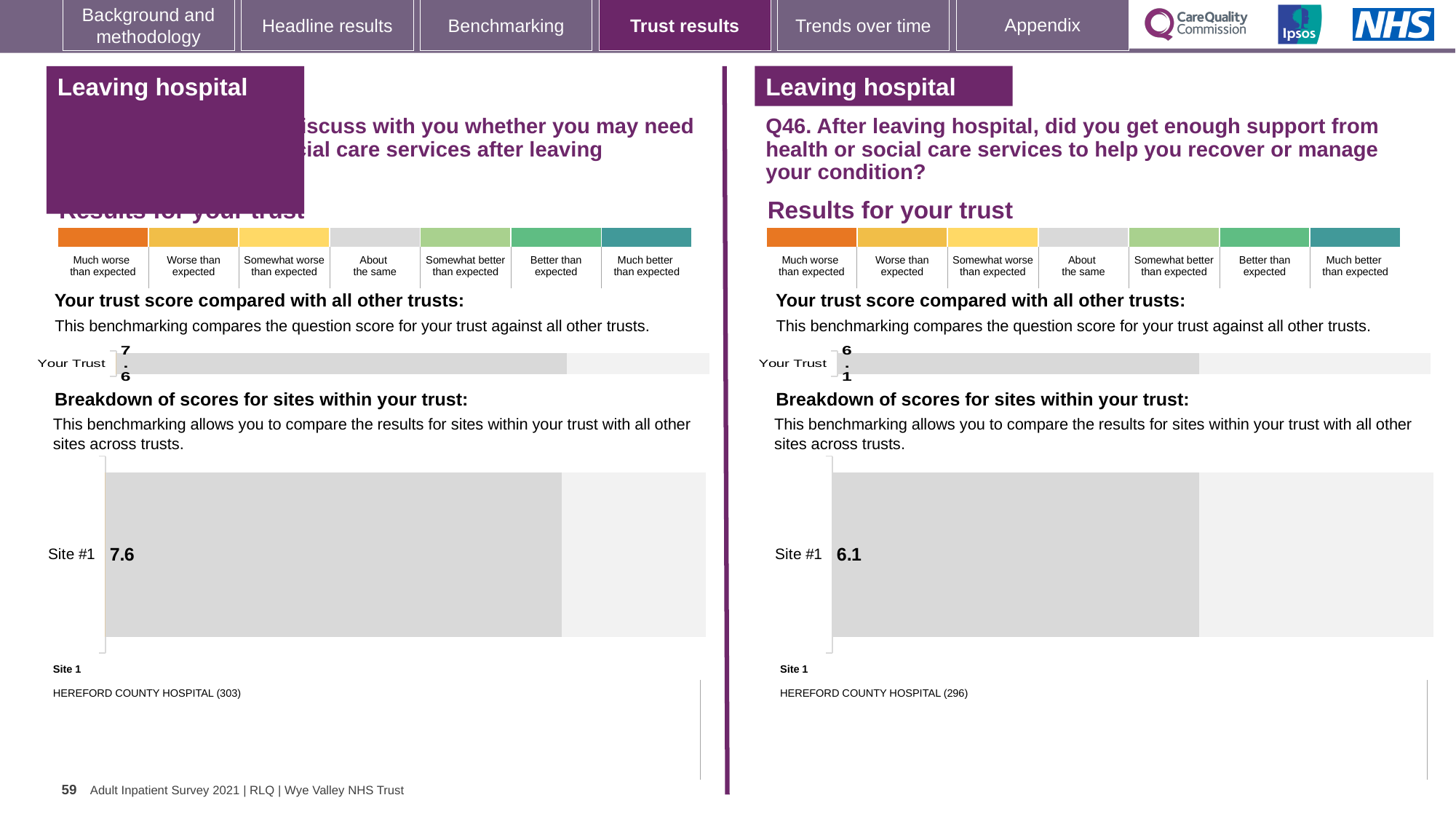
How many sites are shown in the site breakdown chart on the left-hand side? 1 On the left-hand chart, which hospital is listed as Site 1? HEREFORD COUNTY HOSPITAL (303) What is the difference between the Site #1 score on the left-hand chart and the Site #1 score on the right-hand chart for Q46? 1.5 On the right-hand chart for Q46, what is the 'Your Trust' score? 6.1 What type of chart is used for the site breakdown on the right-hand side for Q46? Bar chart On the left-hand site breakdown chart, what is the score shown for Site #1? 7.6 On the left-hand chart, what is the 'Your Trust' score? 7.6 On the right-hand chart for Q46, which hospital is listed as Site 1? HEREFORD COUNTY HOSPITAL (296) On the right-hand chart for Q46, what is the score shown for Site #1? 6.1 How many sites are shown in the site breakdown chart on the right-hand side for Q46? 1 Which is larger: the Site #1 score on the left-hand chart or the Site #1 score on the right-hand chart for Q46? Left-hand chart (7.6)